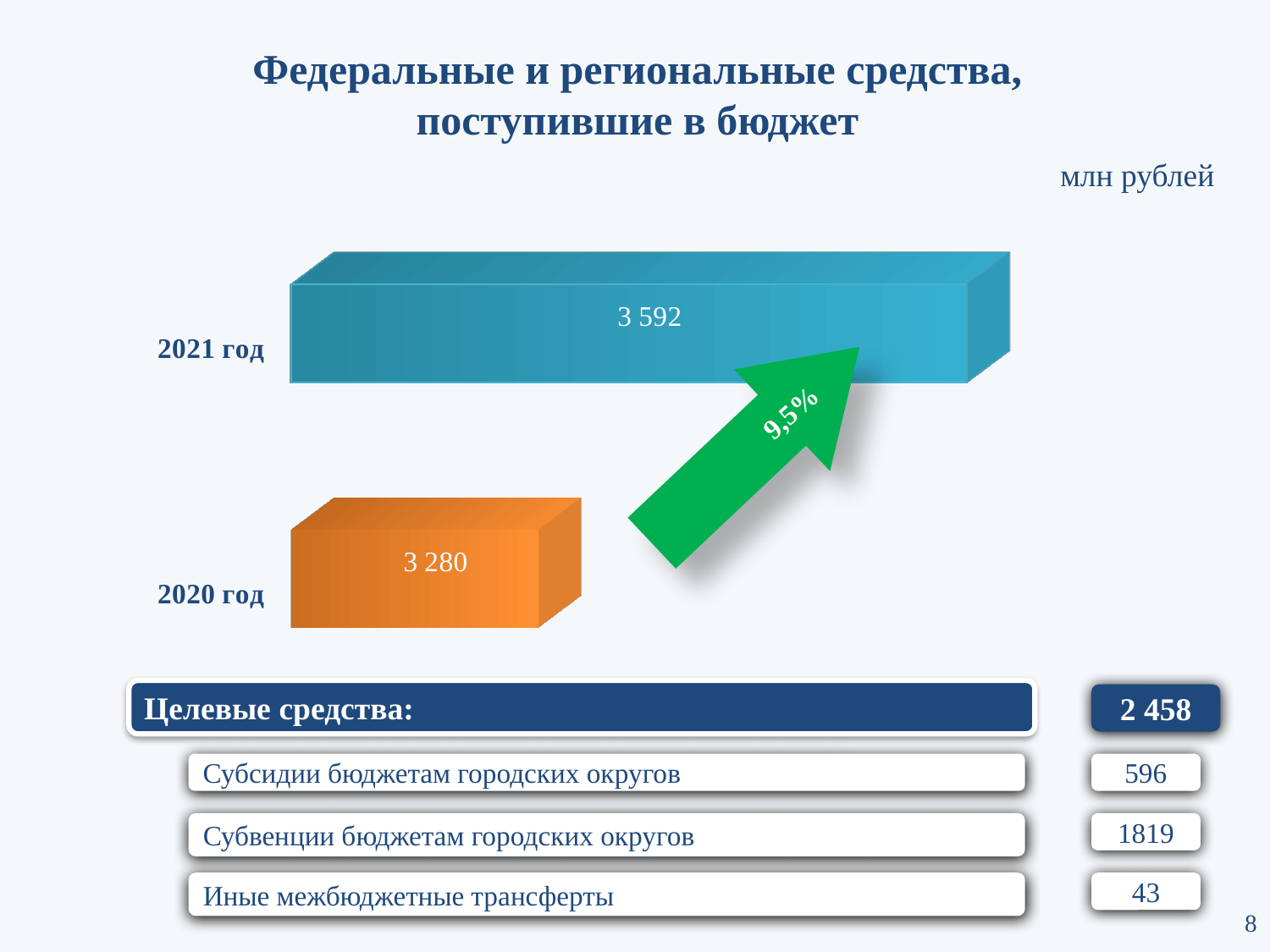
Which year has the higher value? 2021 год What percentage change is shown on the green arrow? 9,5% What unit of measurement is indicated for the chart? млн рублей What is the difference between the values for 2021 год and 2020 год? 312 How many categories (years) are shown in the chart? 2 What is the value for 2021 год? 3 592 What is the value for 2020 год? 3 280 Is the value for 2021 год larger or smaller than the value for 2020 год? larger Do the values rise or fall from 2020 год to 2021 год? rise Which year has the lower value? 2020 год What kind of chart is shown on the slide? bar chart